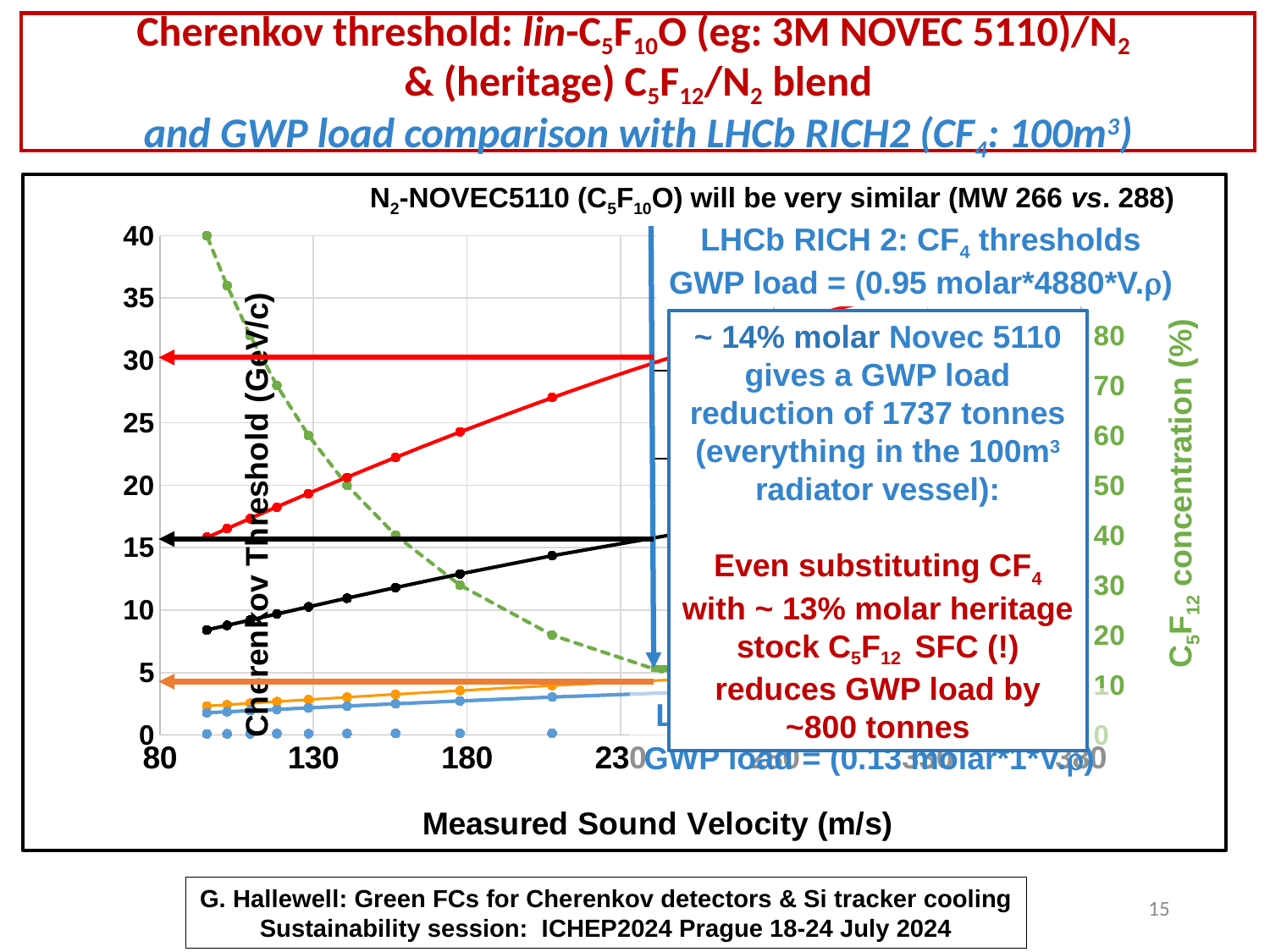
Is the Cherenkov threshold on the red line at a sound velocity of 130 m/s greater or less than 15 GeV/c? greater What is the title of the left-hand y axis of the chart? Cherenkov Threshold (GeV/c) Does the green dashed line rise or fall as the measured sound velocity increases? falls Is the Cherenkov threshold on the black line at a sound velocity of 130 m/s greater or less than 15 GeV/c? less Is the Cherenkov threshold on the black line at a sound velocity of 230 m/s greater or less than 10 GeV/c? greater At a sound velocity of 130 m/s, which line shows the higher Cherenkov threshold, the black line or the orange line? black line What kind of chart is shown on the slide? line chart What is the title of the x axis of the chart? Measured Sound Velocity (m/s) At a sound velocity of 180 m/s, which line shows the higher Cherenkov threshold, the red line or the black line? red line Does the black line rise or fall as the measured sound velocity increases? rises Does the red line rise or fall as the measured sound velocity increases? rises